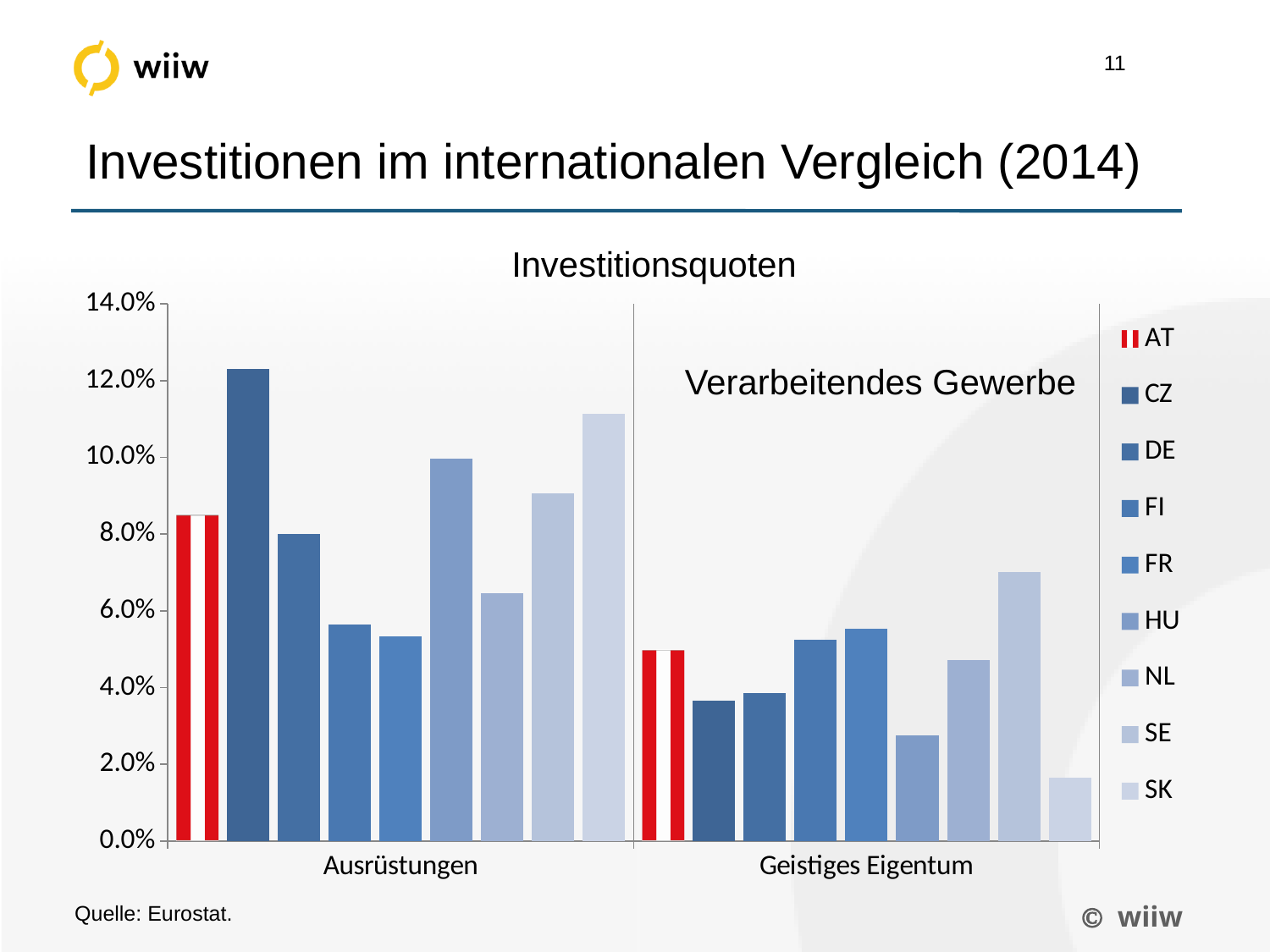
Which is larger for AT: the value for Ausrüstungen or the value for Geistiges Eigentum? Ausrüstungen Is the value for SK in the Ausrüstungen category greater or less than 10.0%? greater How many categories are shown on the x axis? 2 Which country has the highest value in the Geistiges Eigentum category? SE How many series does the legend list? 9 In the Geistiges Eigentum category, which is larger: the value for HU or the value for NL? NL Is the value for SK in the Geistiges Eigentum category greater or less than 2.0%? less What is the title of the chart? Investitionsquoten Which country has the lowest value in the Geistiges Eigentum category? SK Which country has the highest value in the Ausrüstungen category? CZ What kind of chart is shown on the slide? Bar chart Is the value for AT in the Ausrüstungen category greater or less than 8.0%? greater